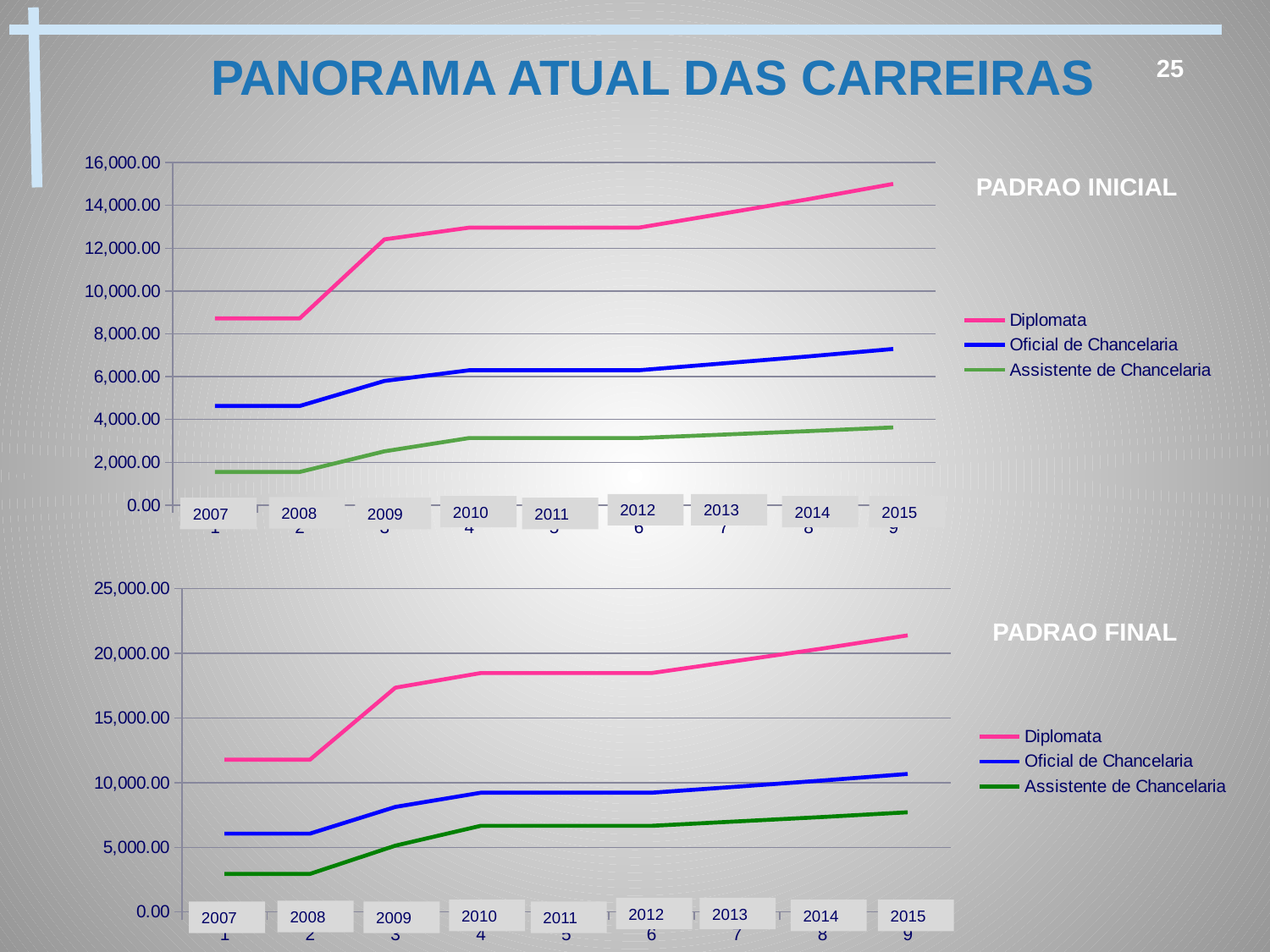
What colour is the Diplomata line in the PADRAO FINAL chart? pink In the PADRAO INICIAL chart, does the Diplomata line generally rise or fall from 2007 to 2015? rise In the PADRAO FINAL chart, is the value for Assistente de Chancelaria in 2007 greater or less than 5,000.00? less In the PADRAO FINAL chart, is the value for Diplomata in 2015 greater or less than 20,000.00? greater What kind of chart is the PADRAO INICIAL chart? line chart In the PADRAO FINAL chart, which series has the lowest values? Assistente de Chancelaria In the PADRAO FINAL chart, which is larger in 2015: Oficial de Chancelaria or Assistente de Chancelaria? Oficial de Chancelaria How many years are plotted along the x axis of the PADRAO INICIAL chart? 9 In the PADRAO INICIAL chart, which series has the highest values? Diplomata In the PADRAO INICIAL chart, is the value for Diplomata in 2015 greater or less than 14,000.00? greater How many series does the legend of the PADRAO FINAL chart list? 3